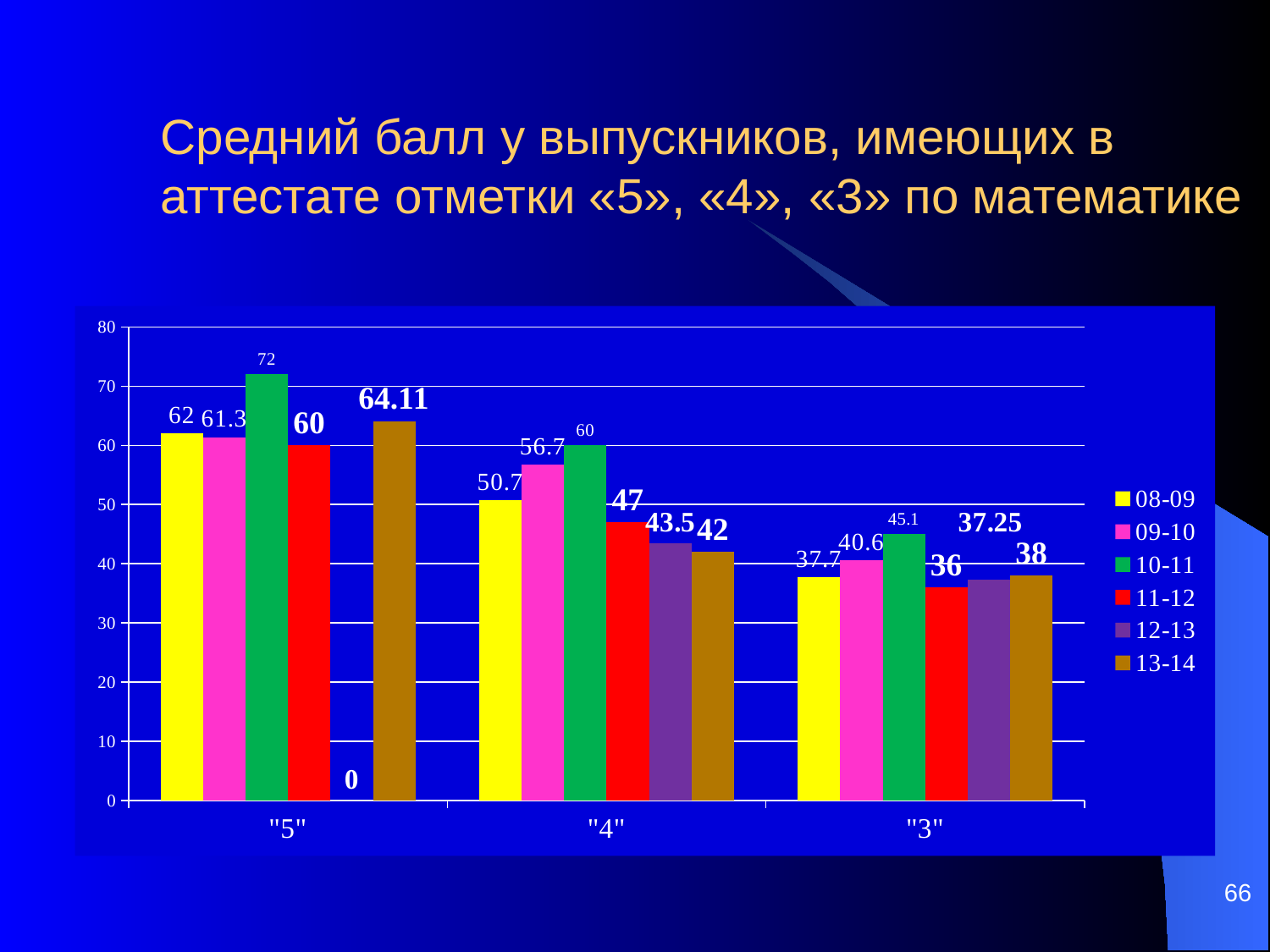
How many series does the legend list? 6 What is the value for series 12-13 in category "3"? 37.25 What is the value for series 09-10 in category "4"? 56.7 Which is larger: the 08-09 value in category "4" or the 09-10 value in category "4"? 09-10 What is the difference between the 10-11 value and the 11-12 value in category "5"? 12 Which series has the highest value in category "4"? 10-11 Which series has the lowest value in category "3"? 11-12 What kind of chart is shown on the slide? bar chart What is the value for series 10-11 in category "5"? 72 How many categories are shown on the x axis? 3 Is the value for series 10-11 in category "3" greater or less than 40? greater What is the value for series 13-14 in category "5"? 64.11